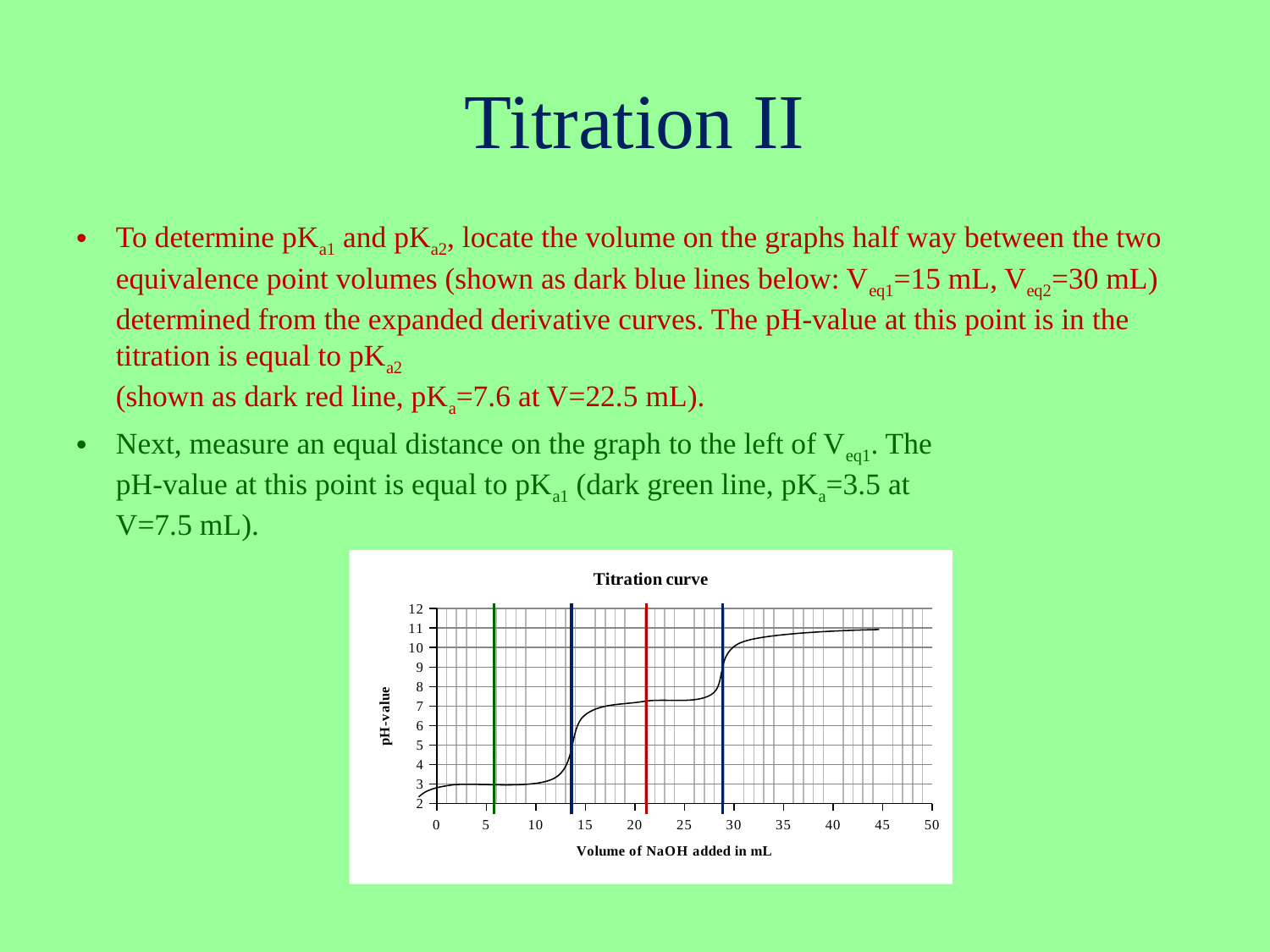
What is the label of the x axis of the chart? Volume of NaOH added in mL Which has the higher pH-value on the titration curve: 10 mL or 40 mL of NaOH added? 40 mL What kind of chart is the "Titration curve" chart? line chart Is the pH-value at 20 mL of NaOH added greater or less than 8? less Does the pH-value rise or fall as the volume of NaOH added increases along the x axis? rise What is the title of the chart on the slide? Titration curve Which has the lower pH-value on the titration curve: 5 mL or 25 mL of NaOH added? 5 mL Is the pH-value at 10 mL of NaOH added greater or less than 4? less Is the pH-value at 45 mL of NaOH added greater or less than 10? greater What is the highest value shown on the pH-value axis of the chart? 12